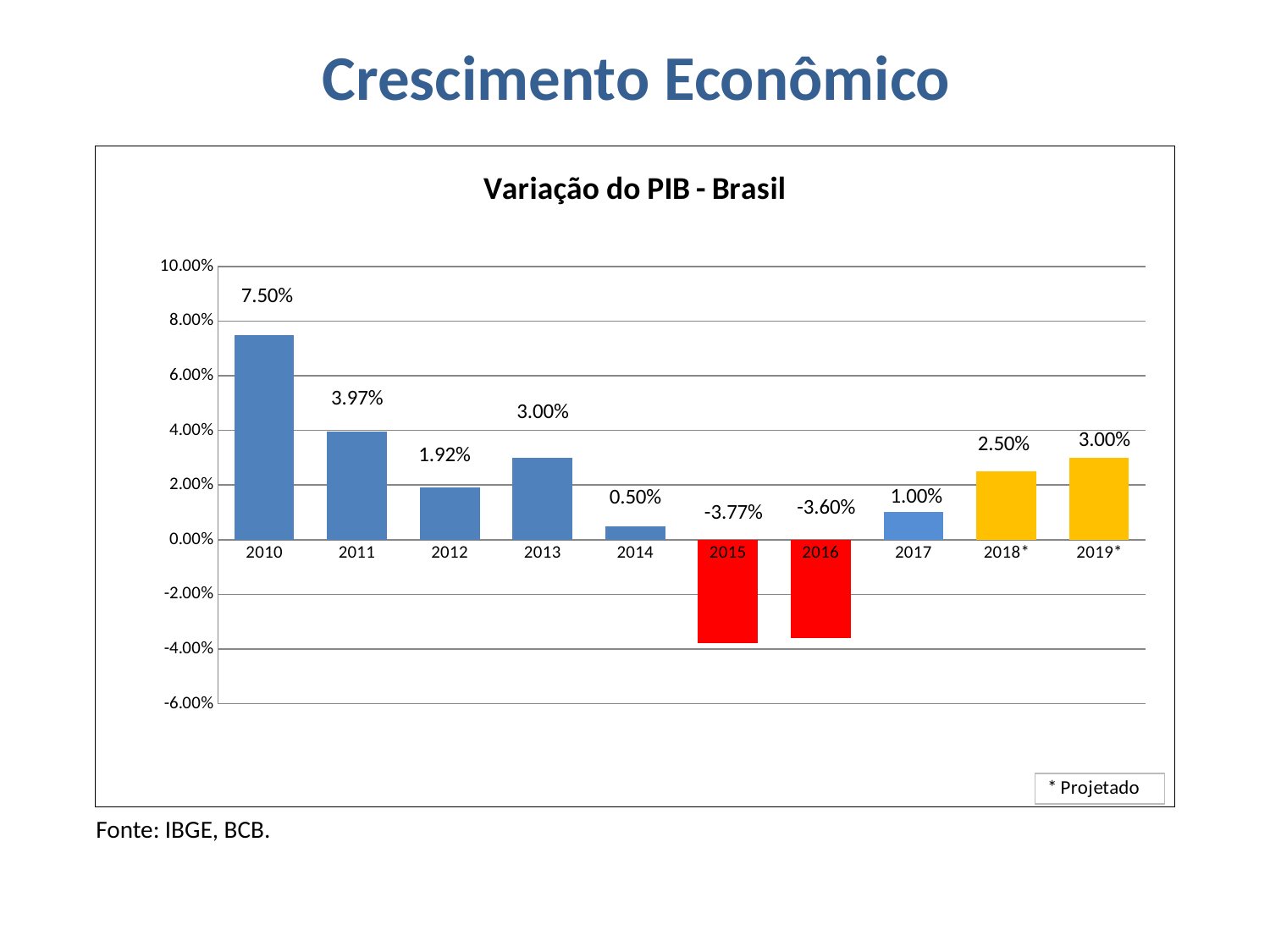
How many years are shown on the x axis? 10 What is the value for 2010? 7.50% What is the value for 2018*? 2.50% Is the value for 2011 greater or less than 2.00%? greater What is the difference between the values for 2010 and 2011? 3.53% Which year has the lowest value? 2015 Do the values rise or fall from 2010 to 2014? Fall Which year has the highest value? 2010 What is the title of the chart? Variação do PIB - Brasil Which is larger, the value for 2013 or the value for 2017? 2013 What kind of chart is this? Bar chart What is the value for 2015? -3.77%